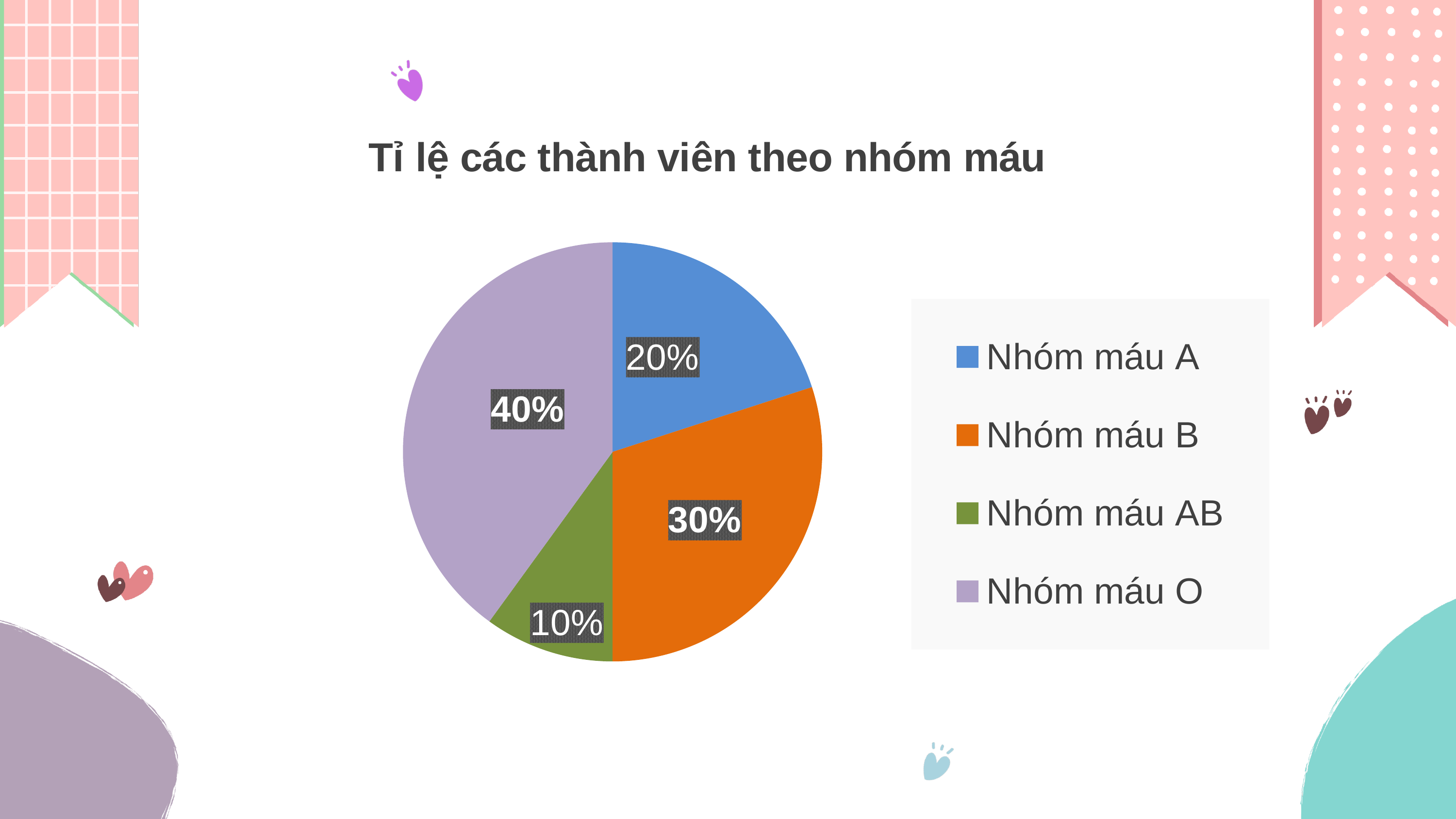
How many blood groups are shown in the pie chart? 4 What kind of chart is shown on the slide? Pie chart Which blood group has the smallest share of members? Nhóm máu AB Which is larger, the share for Nhóm máu B or the share for Nhóm máu A? Nhóm máu B What is the difference in percentage points between Nhóm máu O and Nhóm máu A? 20 What percentage of members have blood group B (Nhóm máu B)? 30% What is the title of the chart? Tỉ lệ các thành viên theo nhóm máu What colour is the slice for Nhóm máu B? Orange What percentage of members have blood group AB (Nhóm máu AB)? 10% What percentage of members have blood group A (Nhóm máu A)? 20% Which blood group has the largest share of members? Nhóm máu O What percentage of members have blood group O (Nhóm máu O)? 40%